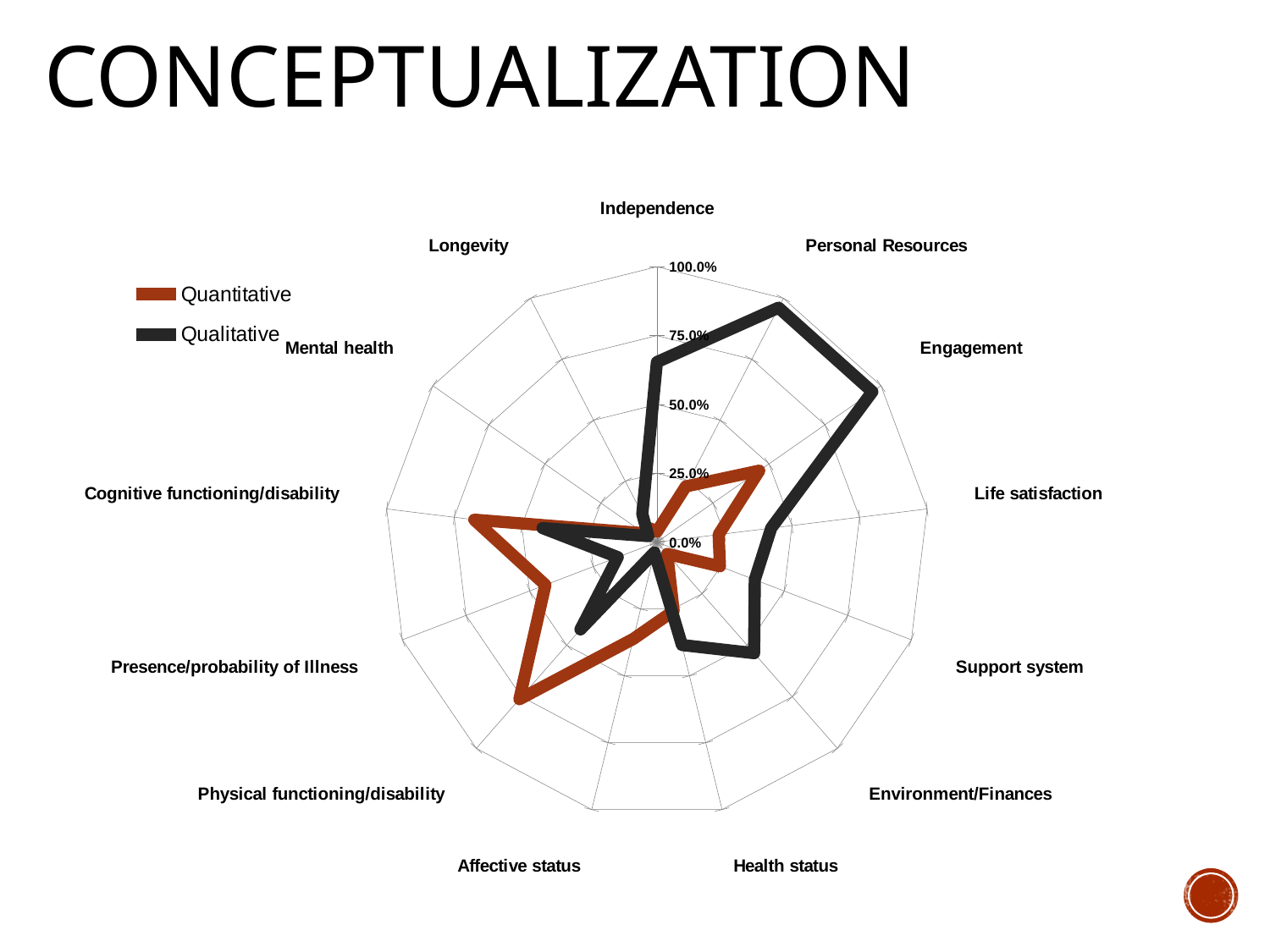
Is the Qualitative value for Personal Resources greater or less than 75.0%? greater For Affective status, which series has the larger value, Quantitative or Qualitative? Quantitative Is the Quantitative value for Cognitive functioning/disability greater or less than 25.0%? greater For Personal Resources, which series has the larger value, Quantitative or Qualitative? Qualitative What kind of chart is shown on the slide? Radar chart Is the Qualitative value for Engagement greater or less than 75.0%? greater Which series is drawn in black? Qualitative How many categories (axes) does the radar chart have? 13 How many series does the legend list? 2 What is the highest value shown on the radial axis? 100.0%